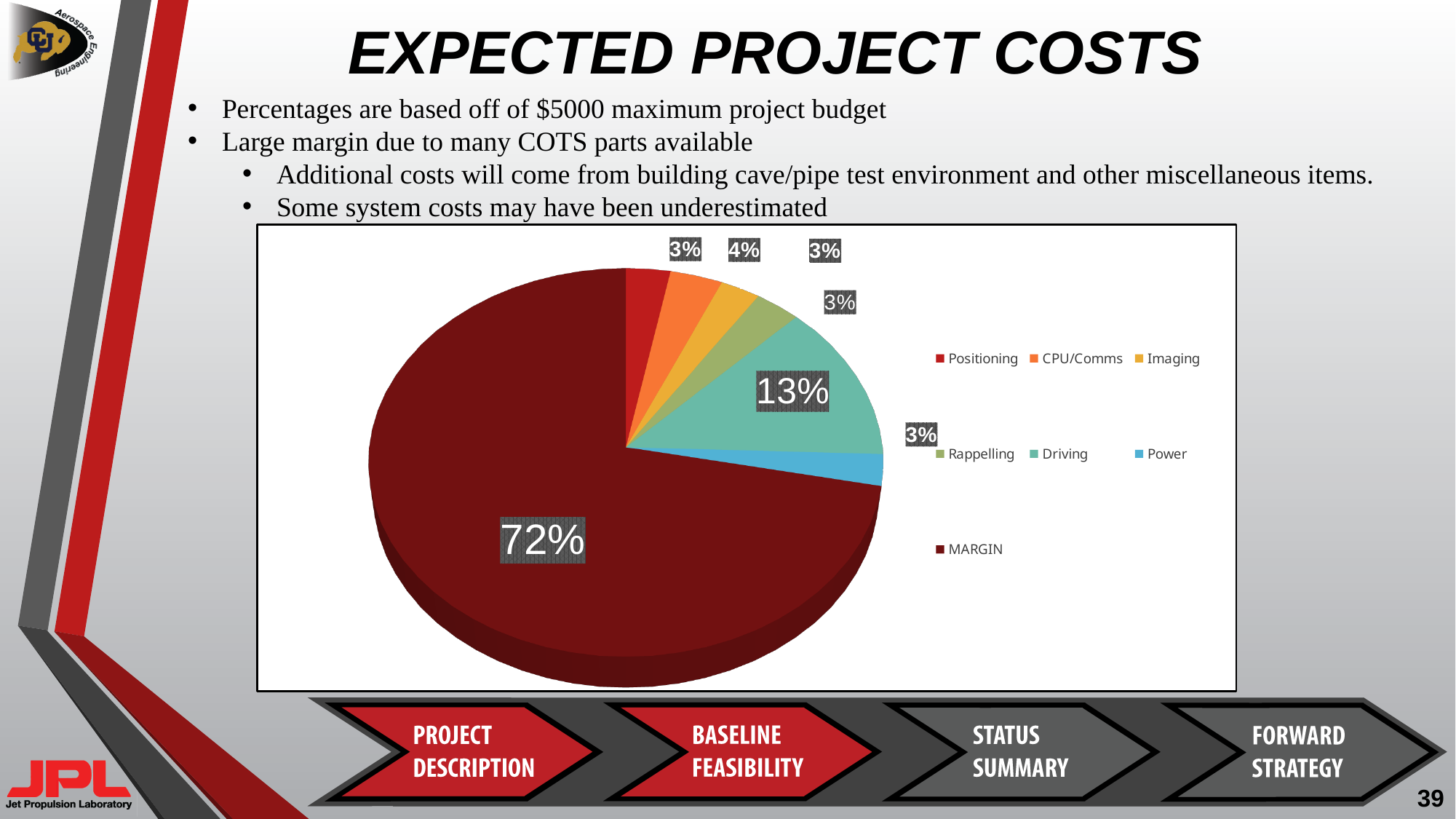
What is the title of the slide containing the pie chart? EXPECTED PROJECT COSTS What share of the pie does the Driving slice represent? 13% What is the difference in percentage points between MARGIN and Driving? 59 percentage points Which category has the largest share of the pie chart? MARGIN What percentage of the budget is allocated to CPU/Comms? 4% What percentage of the budget is allocated to MARGIN? 72% Which is larger, the share for Driving or the share for CPU/Comms? Driving How many categories does the pie chart show? 7 What percentage of the budget is allocated to Power? 3% How many entries are listed in the chart legend? 7 What kind of chart is shown on the slide? Pie chart What percentage of the budget is allocated to Driving? 13%